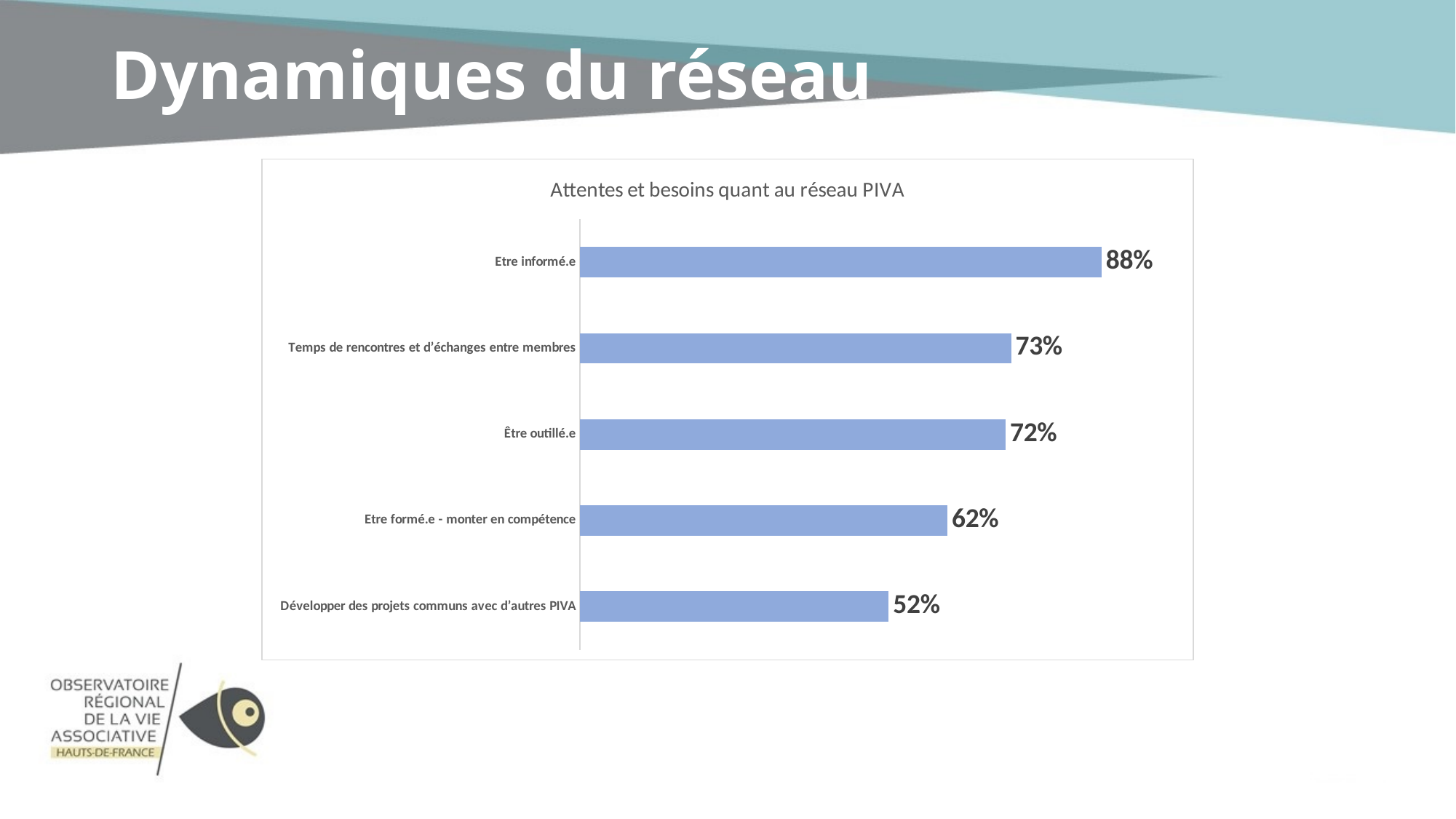
What is the value for "Temps de rencontres et d'échanges entre membres"? 73% What is the value for "Être outillé.e"? 72% How many categories are shown in the chart? 5 Which category has the highest value? Etre informé.e Which is larger: the value for "Etre formé.e - monter en compétence" or the value for "Développer des projets communs avec d'autres PIVA"? Etre formé.e - monter en compétence What is the value for "Etre formé.e - monter en compétence"? 62% What is the value for "Développer des projets communs avec d'autres PIVA"? 52% What is the difference between the values for "Etre informé.e" and "Développer des projets communs avec d'autres PIVA"? 36% What kind of chart is shown on the slide? Bar chart What is the value for "Etre informé.e"? 88% What is the title of the chart? Attentes et besoins quant au réseau PIVA Which category has the lowest value? Développer des projets communs avec d'autres PIVA